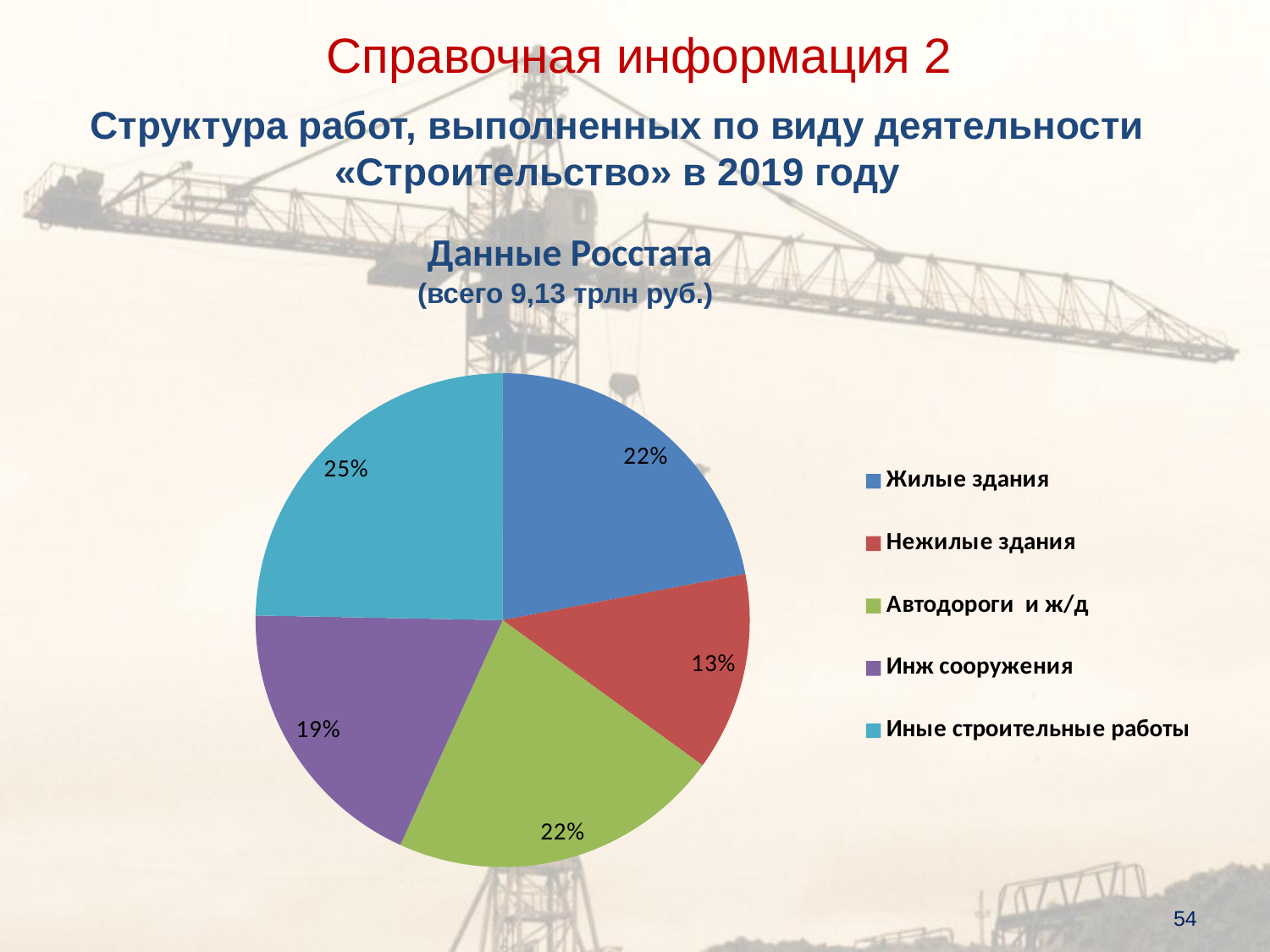
What share of the pie does Жилые здания account for? 22% What is the difference in percentage points between Иные строительные работы and Нежилые здания? 12 Which category has the largest slice of the pie? Иные строительные работы Which category has the smallest slice of the pie? Нежилые здания What is the value shown for Нежилые здания? 13% What share does Иные строительные работы have in the pie chart? 25% How many slices does the pie chart have? 5 What percentage is shown for Инж сооружения? 19% What is the value for Автодороги и ж/д? 22% What type of chart is shown on the slide? pie chart What total amount is stated in the chart title? 9,13 трлн руб. Which is larger, the share for Инж сооружения or the share for Нежилые здания? Инж сооружения